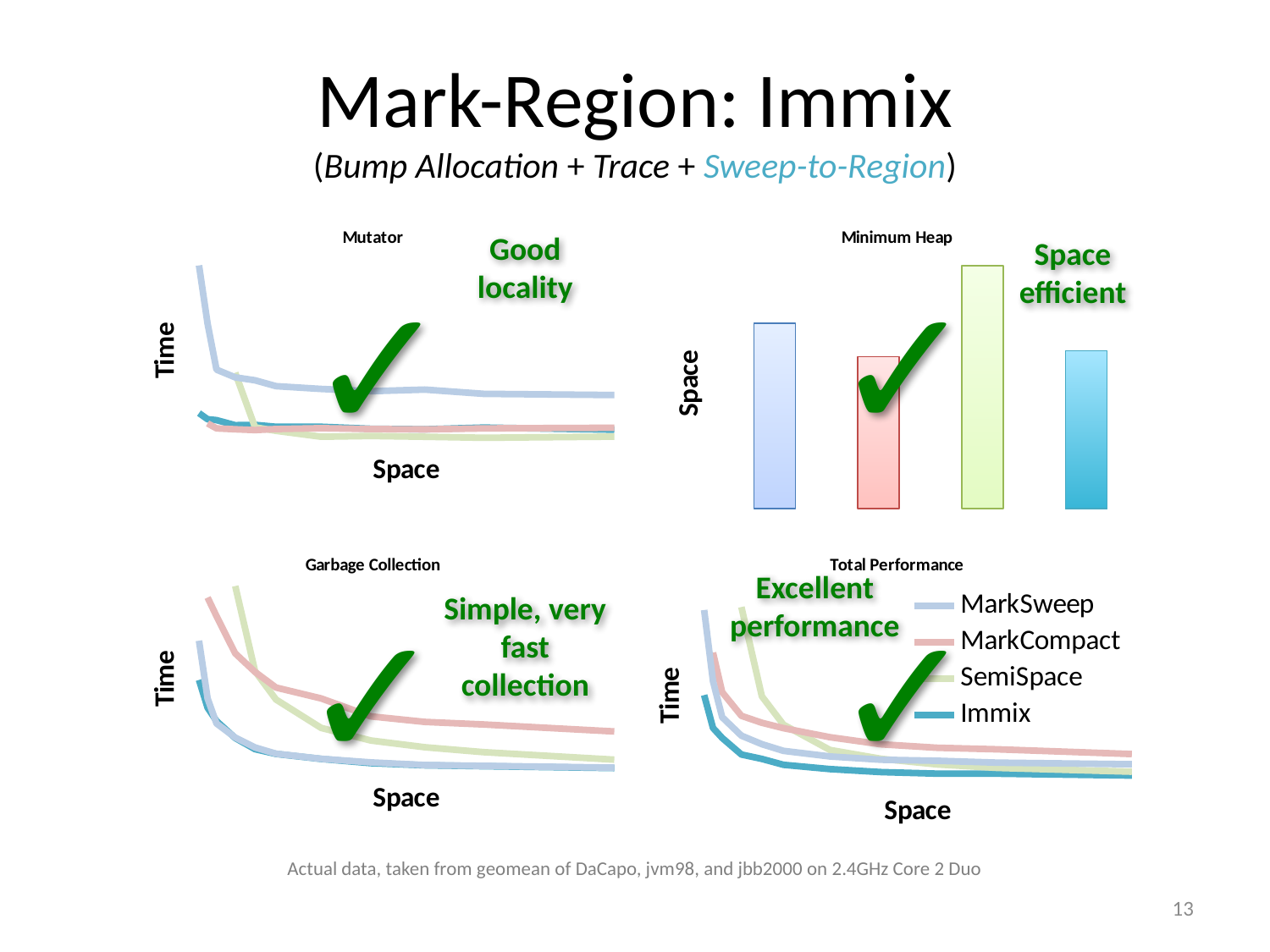
In the Minimum Heap chart, which collector has the tallest bar? SemiSpace In the Minimum Heap chart, which collector has the shortest bar? MarkCompact What kind of chart is the Total Performance chart? line chart In the Minimum Heap chart, which bar is taller, MarkSweep or Immix? MarkSweep How many bars are shown in the Minimum Heap chart? 4 How many series does the legend list? 4 In the Total Performance chart, which series has the lowest line at the right end of the x axis? Immix What kind of chart is the Minimum Heap chart? bar chart In the Garbage Collection chart, which series has the highest line at the right end of the x axis? MarkCompact Which legend entry is drawn in the pink/red colour? MarkCompact What is the x-axis label of the Mutator chart? Space In the Total Performance chart, do the lines rise or fall as Space increases? fall